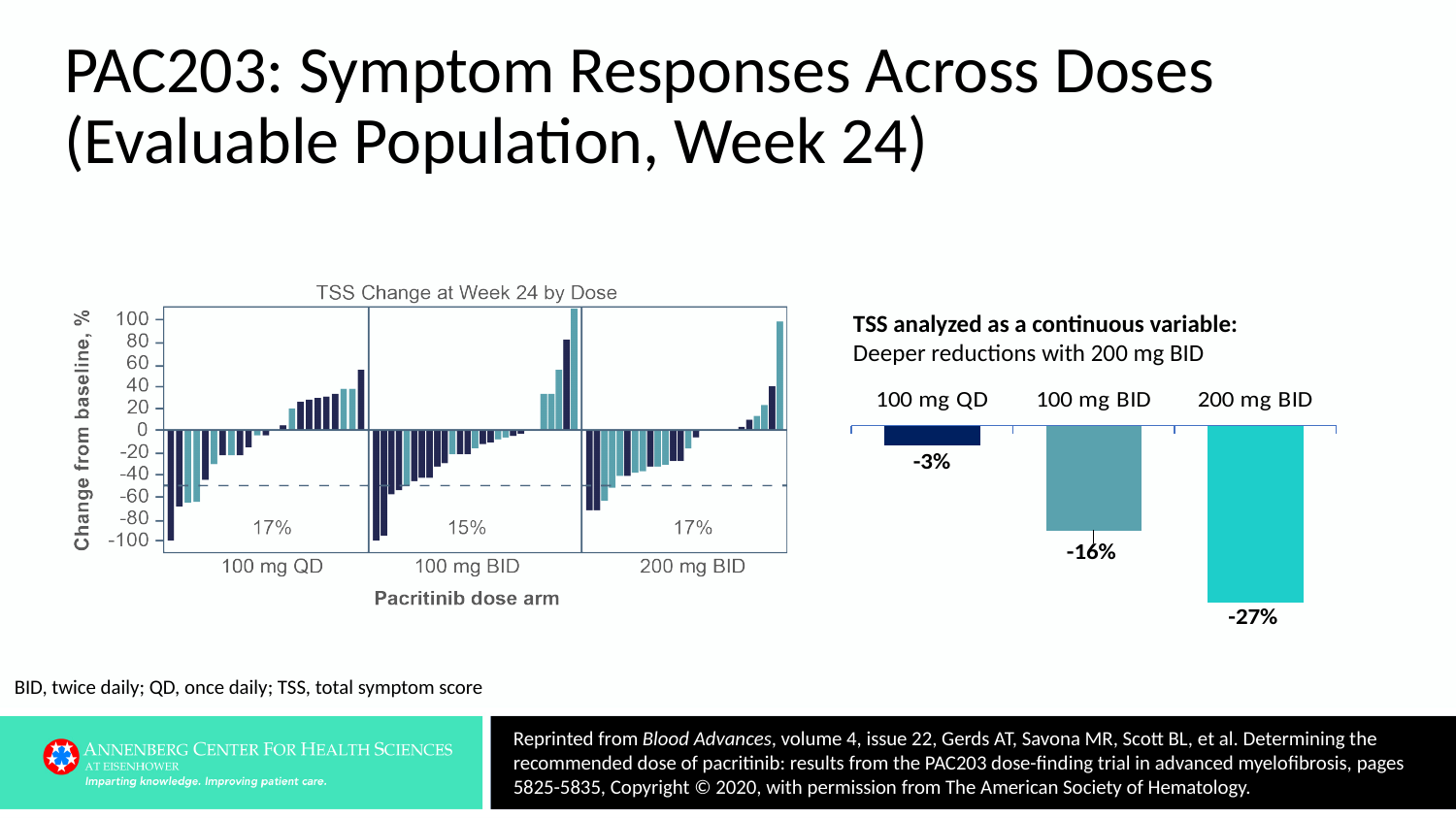
In the right chart, how many dose arms are plotted? 3 In the right chart, which dose arm shows the smallest reduction in TSS? 100 mg QD What type of chart is the right chart? Bar chart In the left chart titled 'TSS Change at Week 24 by Dose', which dose arm has the lowest printed percentage? 100 mg BID In the right chart, what is the value shown for 100 mg BID? -16% In the right chart, which shows a greater reduction: 100 mg QD or 100 mg BID? 100 mg BID In the left chart titled 'TSS Change at Week 24 by Dose', what percentage is printed for the 100 mg BID arm? 15% In the right chart, what is the value shown for 200 mg BID? -27% What is the y-axis label of the left chart? Change from baseline, % In the right chart, which dose arm shows the largest reduction in TSS? 200 mg BID In the right chart, by how many percentage points does the reduction for 200 mg BID exceed that for 100 mg BID? 11 percentage points In the right chart, what is the value shown for 100 mg QD? -3%